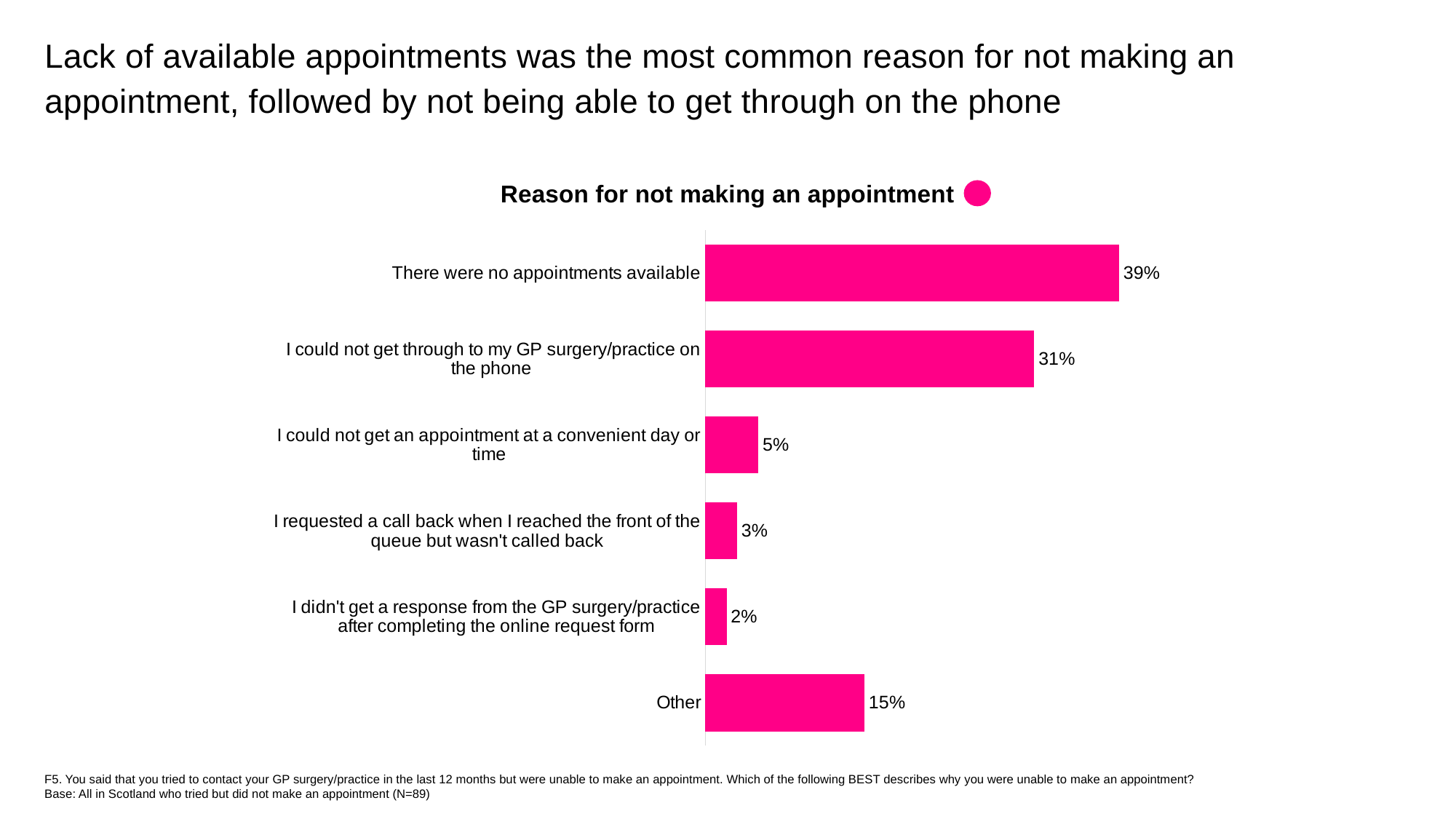
What percentage of respondents said there were no appointments available? 39% Which reason has the highest percentage? There were no appointments available What is the base size (N) stated for the chart? N=89 What is the value for 'I could not get through to my GP surgery/practice on the phone'? 31% What is the difference in percentage points between 'There were no appointments available' and 'I could not get through to my GP surgery/practice on the phone'? 8 percentage points How many reasons (categories) are shown in the chart? 6 What is the value for 'I didn't get a response from the GP surgery/practice after completing the online request form'? 2% What is the title of the chart? Reason for not making an appointment What percentage is shown for 'Other'? 15% Which is larger: the value for 'Other' or the value for 'I could not get an appointment at a convenient day or time'? Other Which reason has the lowest percentage? I didn't get a response from the GP surgery/practice after completing the online request form What kind of chart is shown on the slide? Bar chart